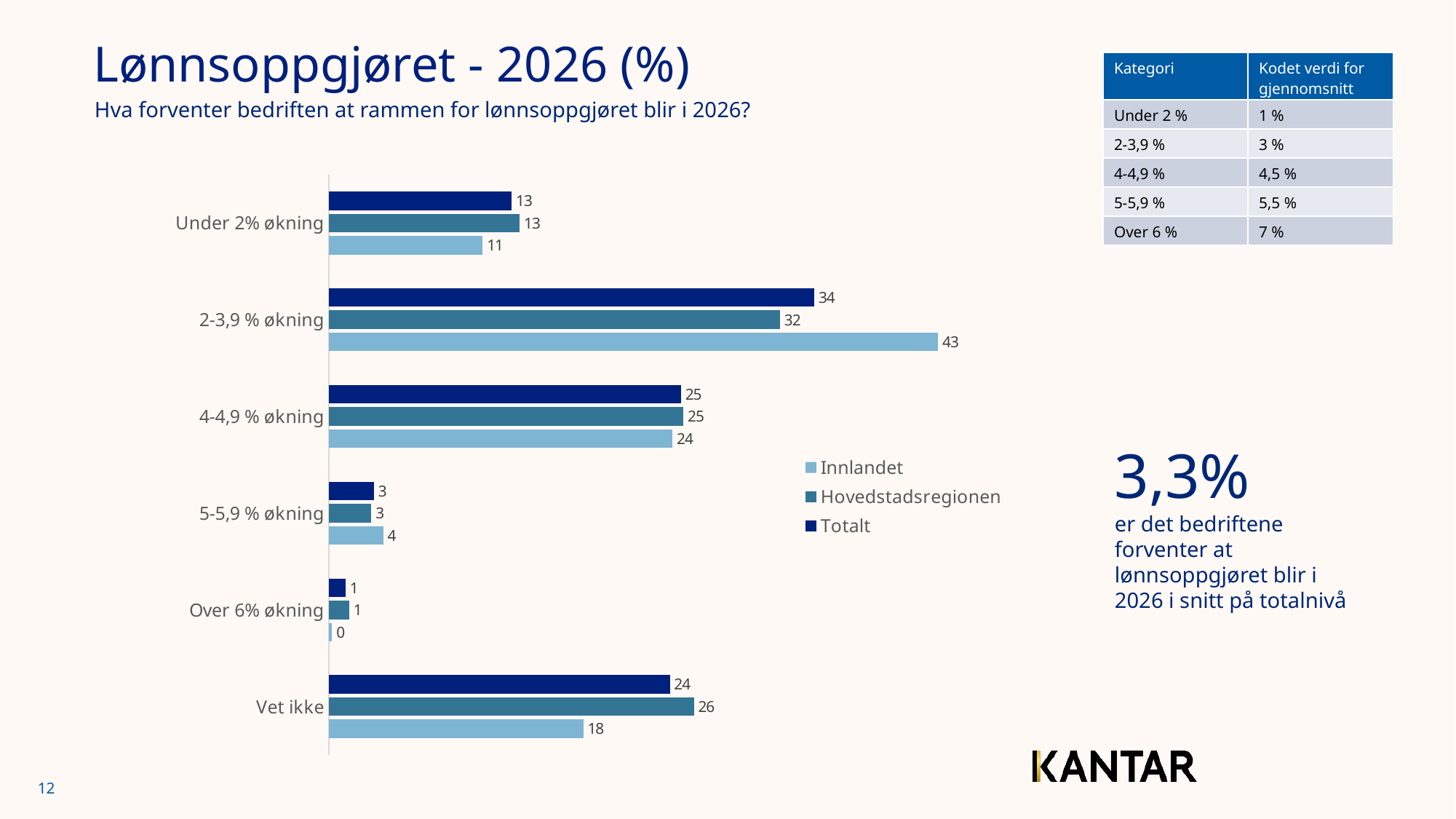
What is the Hovedstadsregionen value for "Under 2% økning"? 13 Which category has the highest Totalt value? 2-3,9 % økning Which series is shown in the darkest blue colour? Totalt What is the Totalt value for "Vet ikke"? 24 How many series does the legend list? 3 How many categories are shown on the chart? 6 What is the Innlandet value for "2-3,9 % økning"? 43 What is the Innlandet value for "Over 6% økning"? 0 For "Vet ikke", which is larger: the Hovedstadsregionen value or the Innlandet value? Hovedstadsregionen What is the difference between the Innlandet and Hovedstadsregionen values for "2-3,9 % økning"? 11 Which category has the lowest Innlandet value? Over 6% økning What kind of chart is shown on the slide? Bar chart